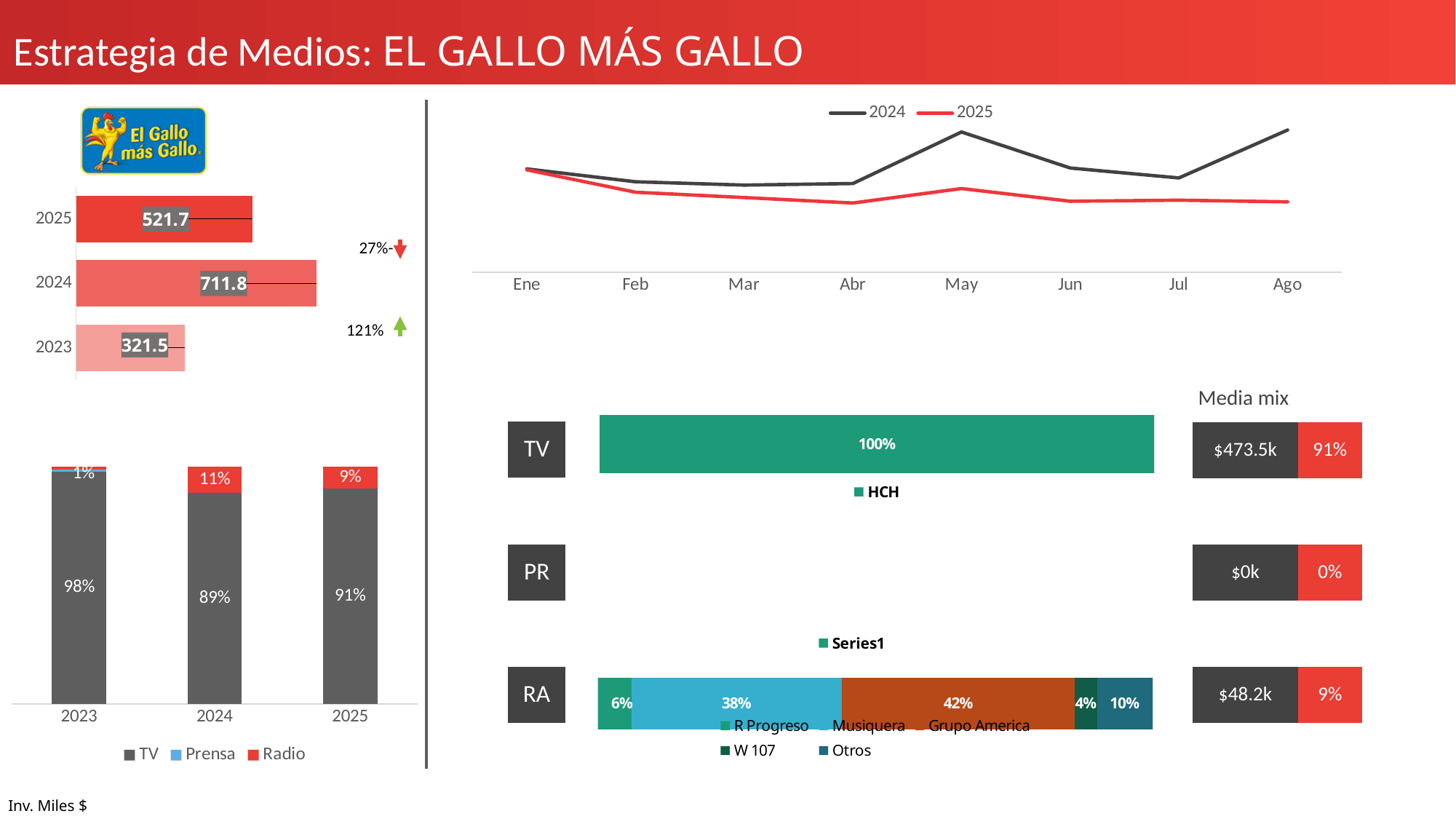
In the Media mix table on the right, what is the amount shown for TV? $473.5k In the top-left bar chart of yearly investment, which is larger, the value for 2025 or the value for 2023? 2025 In the RA stacked bar on the right, what is the share for Grupo America? 42% In the top-left bar chart of yearly investment, which year has the highest value? 2024 In the top-right line chart, how many months are shown on the x axis? 8 In the top-right line chart, which series is higher in May, 2024 or 2025? 2024 In the top-left bar chart of yearly investment, what is the value for 2024? 711.8 How many series does the legend of the bottom-left stacked bar chart list? 3 In the top-left bar chart of yearly investment, what is the difference between the 2024 and 2025 values? 190.1 In the bottom-left stacked bar chart, what is the TV share for 2024? 89% In the top-left bar chart of yearly investment, what is the value for 2023? 321.5 In the bottom-left stacked bar chart, what is the Radio share for 2025? 9%